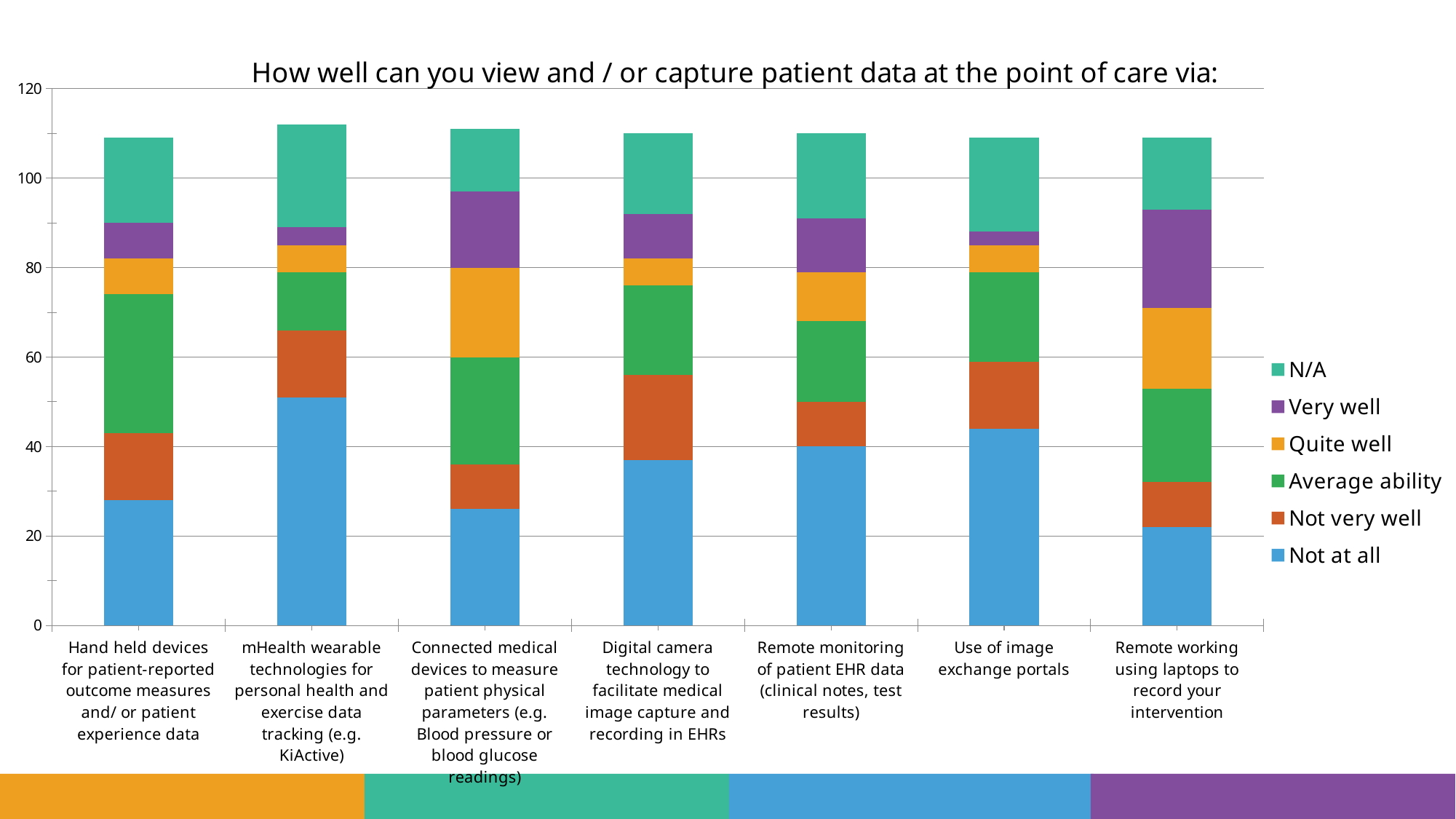
Which category has the largest 'Not at all' segment? mHealth wearable technologies for personal health and exercise data tracking (e.g. KiActive) What kind of chart is shown on the slide? Stacked bar chart Is the 'Not at all' value for 'mHealth wearable technologies for personal health and exercise data tracking (e.g. KiActive)' greater or less than 40? greater Which has the larger 'Not at all' value: 'mHealth wearable technologies' or 'Remote working using laptops to record your intervention'? mHealth wearable technologies How many categories are shown along the x axis of the chart? 7 What is the title of the chart? How well can you view and / or capture patient data at the point of care via: Which has the larger 'Very well' segment: 'Use of image exchange portals' or 'Remote working using laptops to record your intervention'? Remote working using laptops to record your intervention How many series does the legend list? 6 Is the 'Not at all' value for 'Hand held devices for patient-reported outcome measures and/ or patient experience data' greater or less than 40? less Is the 'Not at all' value for 'Remote working using laptops to record your intervention' greater or less than 40? less Which legend entry is shown in blue? Not at all Which category has the largest 'Very well' segment? Remote working using laptops to record your intervention